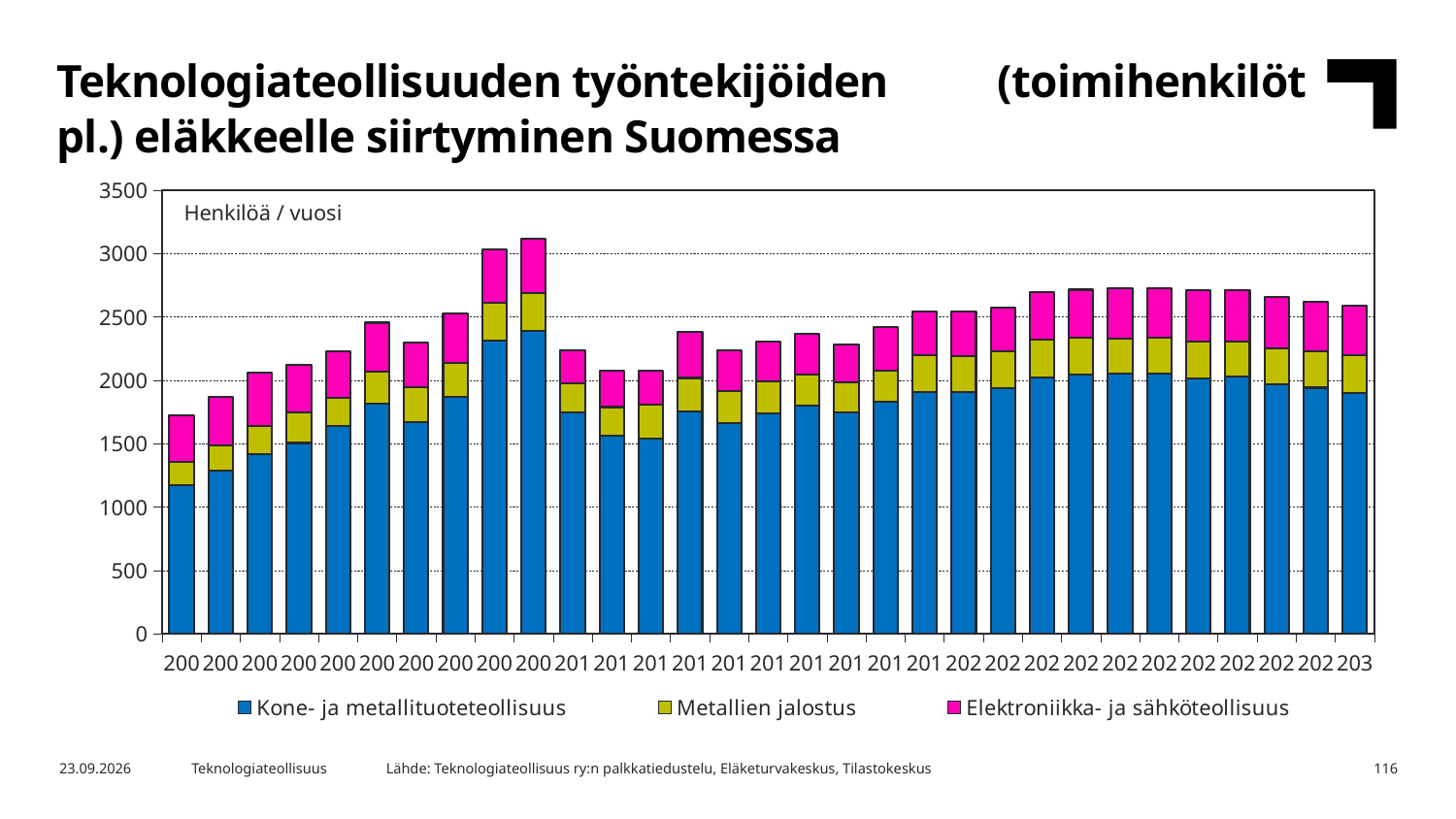
How many bars have a total above 3000? 2 How many series does the legend list? 3 Is the total of the tallest bar greater or less than 3000? greater Which is larger, the total of the leftmost bar or the total of the rightmost bar? the rightmost bar Is the total of the leftmost bar greater or less than 2000? less What unit label is printed inside the plot area? Henkilöä / vuosi How many bars are plotted in the chart? 31 Is the total of the rightmost bar greater or less than 2500? greater What kind of chart is shown on the slide? stacked bar chart Which series forms the bottom (blue) segment of each stacked bar? Kone- ja metallituoteteollisuus